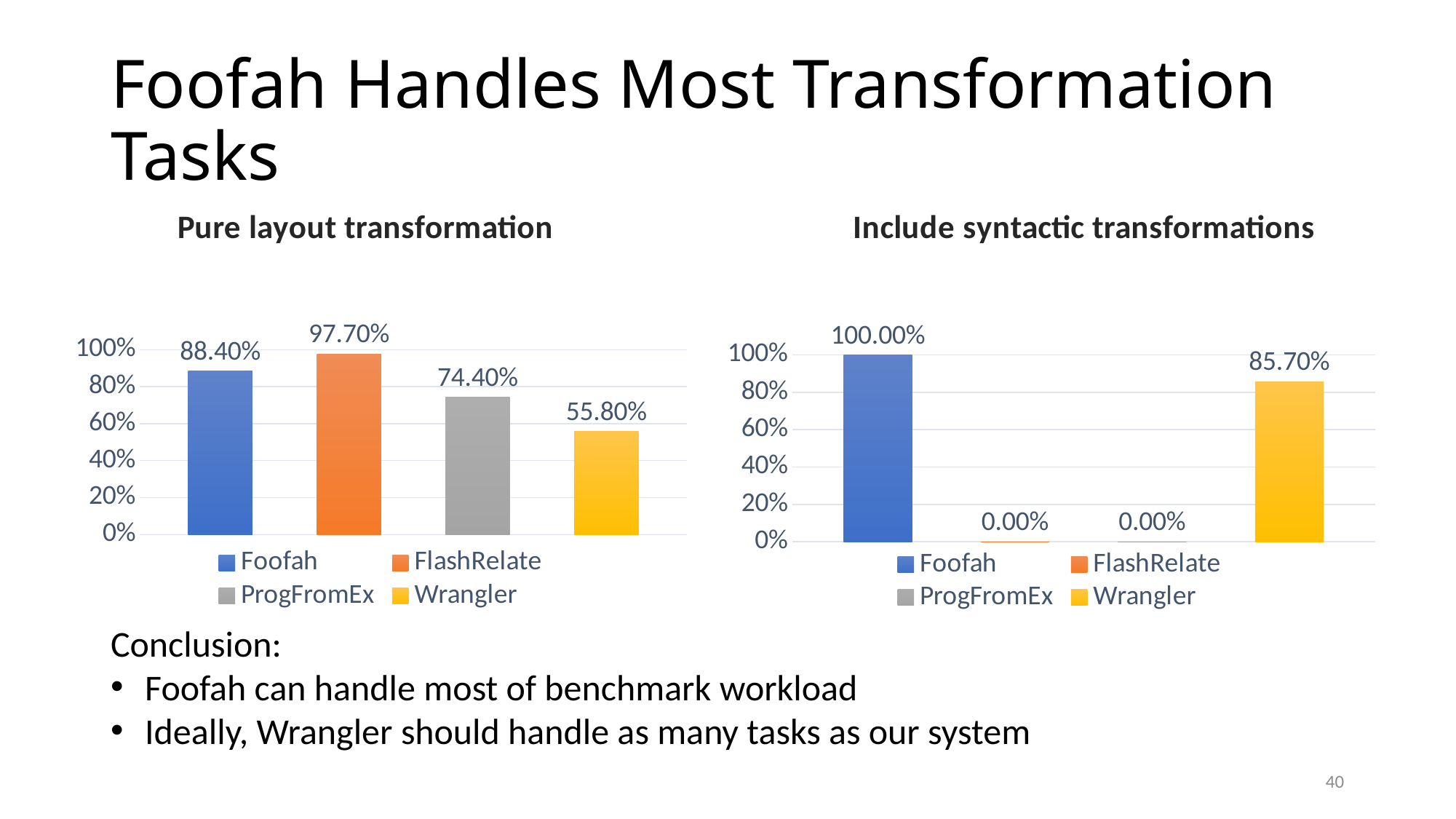
What kind of chart is the 'Pure layout transformation' chart? Bar chart In the 'Include syntactic transformations' chart, what is the value for Wrangler? 85.70% In the 'Include syntactic transformations' chart, what is the difference between the values for Foofah and Wrangler? 14.30% In the 'Pure layout transformation' chart, which is larger, the value for Foofah or the value for ProgFromEx? Foofah In the 'Pure layout transformation' chart, which system has the highest value? FlashRelate In the 'Pure layout transformation' chart, what is the value for Wrangler? 55.80% How many series does the legend of the 'Include syntactic transformations' chart list? 4 In the 'Include syntactic transformations' chart, which system has the highest value? Foofah In the 'Pure layout transformation' chart, what is the difference between the values for FlashRelate and Foofah? 9.30% In the 'Include syntactic transformations' chart, what is the value for Foofah? 100.00% In the 'Pure layout transformation' chart, which system has the lowest value? Wrangler In the 'Pure layout transformation' chart, what is the value for FlashRelate? 97.70%